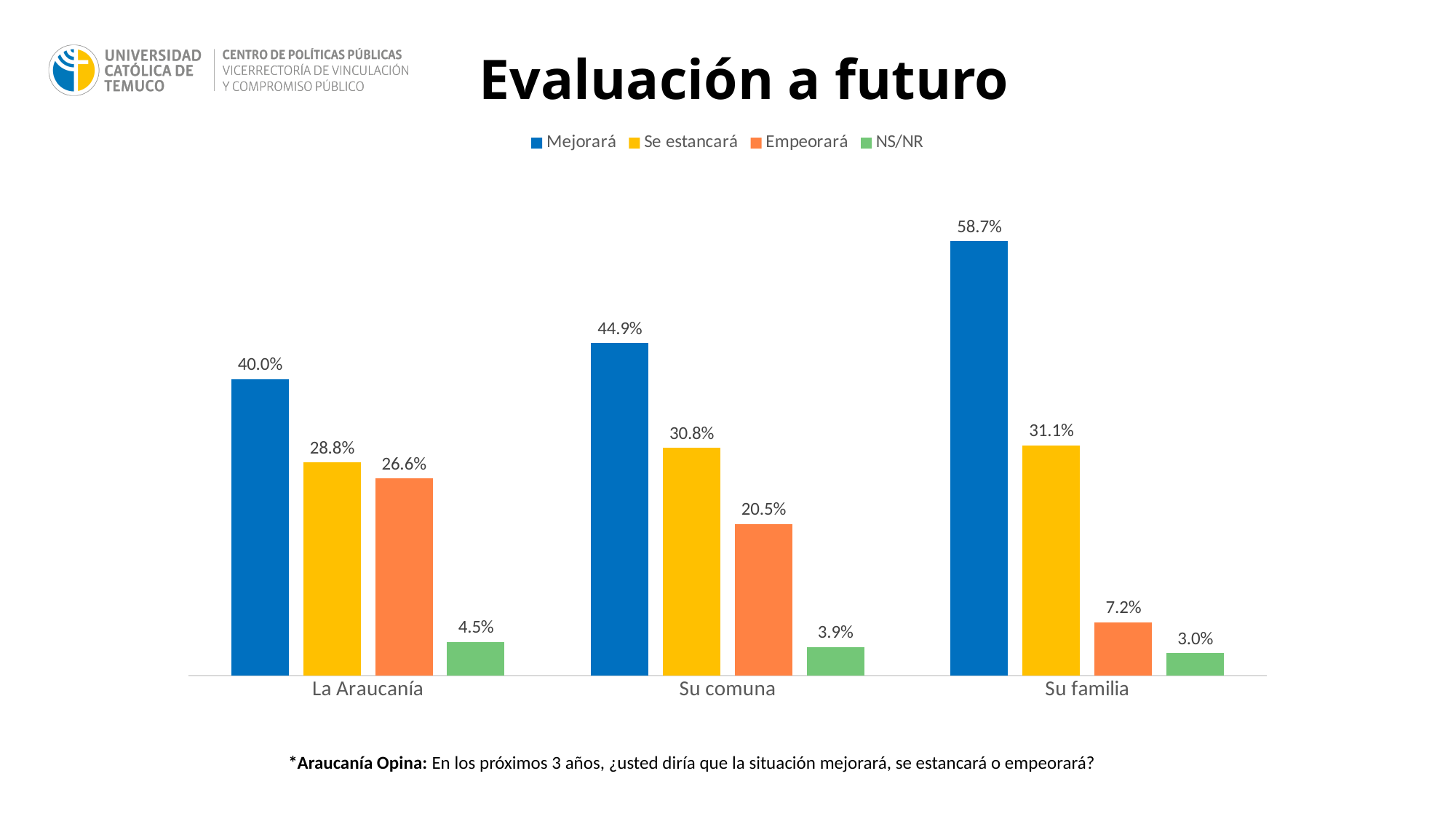
Which category has the lowest value for Empeorará? Su familia Which category has the highest value for Mejorará? Su familia What kind of chart is shown on the slide? Bar chart What is the difference between the Mejorará values for Su familia and La Araucanía? 18.7% How many categories are shown on the x axis? 3 What is the value for Mejorará in the Su familia category? 58.7% What is the value for Se estancará in the Su comuna category? 30.8% Which is larger: Se estancará for Su familia or Se estancará for La Araucanía? Su familia What is the value for NS/NR in the Su comuna category? 3.9% How many series does the legend list? 4 What is the value for Empeorará in the La Araucanía category? 26.6% What is the title of the chart? Evaluación a futuro